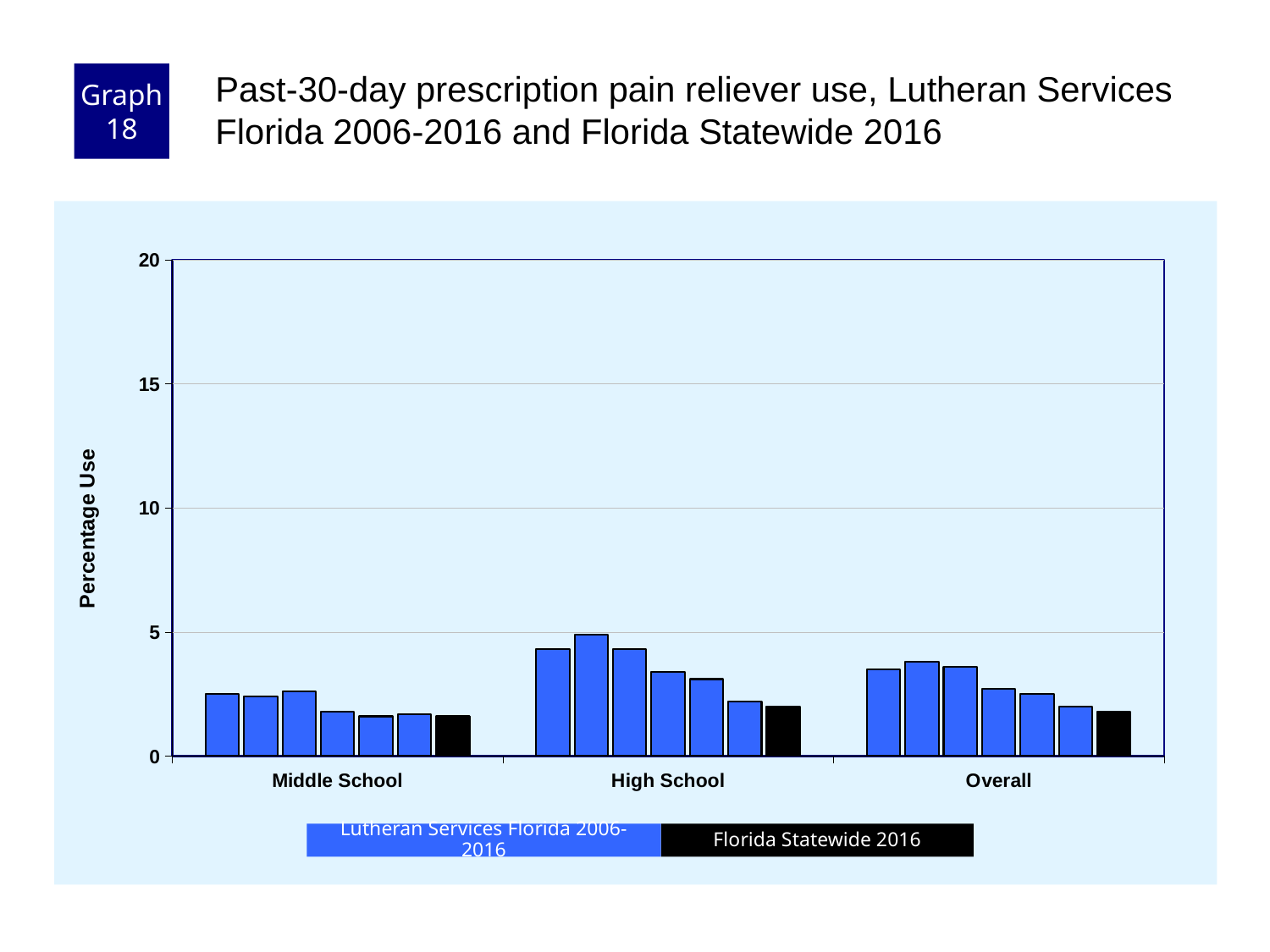
Is the Florida Statewide 2016 value for Middle School greater or less than 5? less How many school-level categories are shown on the x axis? 3 Is the Florida Statewide 2016 value for High School greater or less than 5? less How many series does the legend list? 2 Which category has the highest bars overall? High School What is the label on the y axis? Percentage Use Which category has the lowest bars overall? Middle School Are all the Overall bars greater or less than 5? less What colour represents Florida Statewide 2016 in the legend? black Do the Lutheran Services Florida bars for High School generally rise or fall from the first to the last bar? fall Which is larger, the Florida Statewide 2016 bar for High School or for Middle School? High School What kind of chart is shown on the slide? bar chart